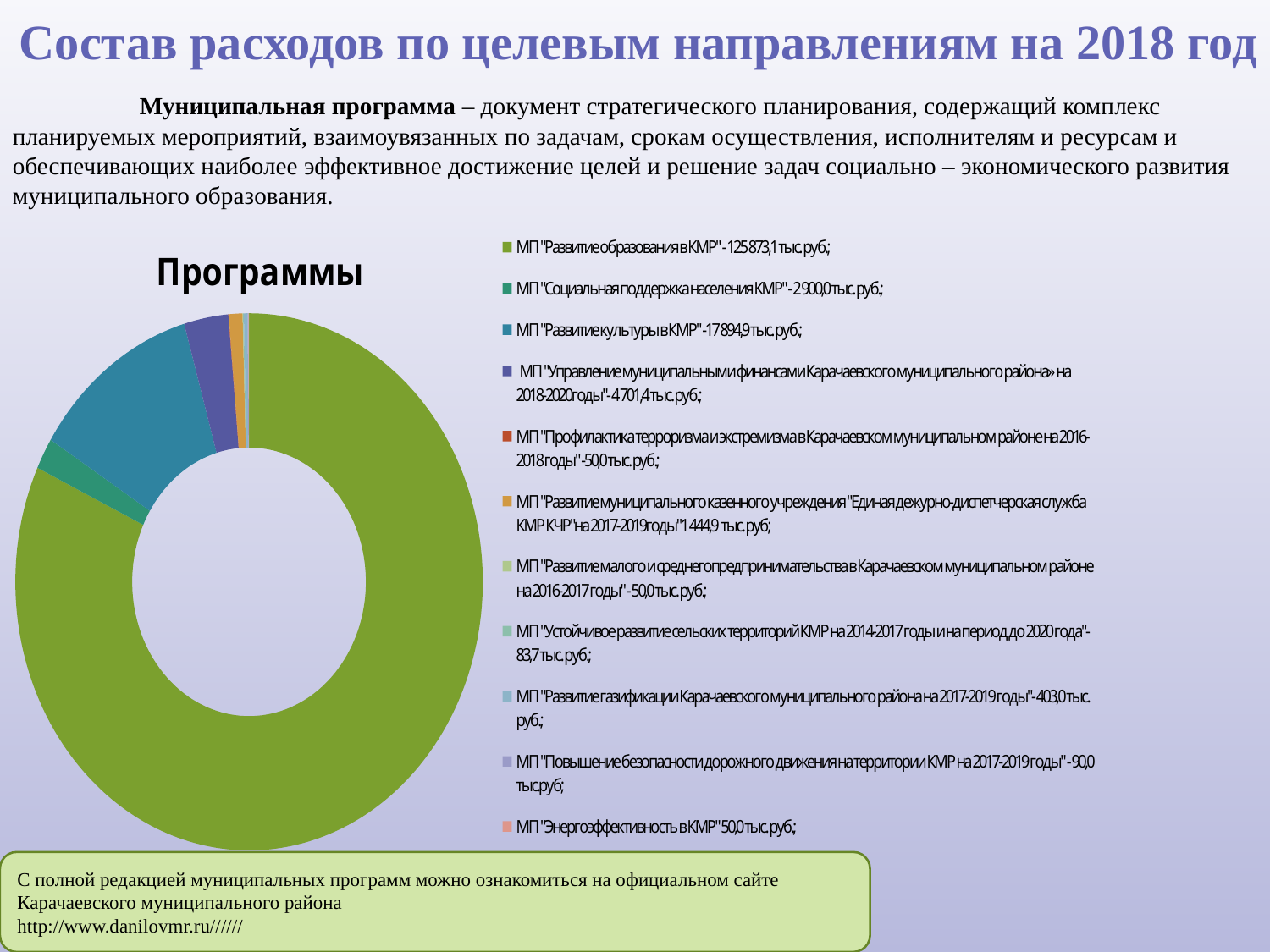
What kind of chart is shown under the heading "Программы"? Pie (doughnut) chart What is the value for МП "Социальная поддержка населения КМР"? 2 900,0 тыс.руб. Which is larger: the value for МП "Развитие культуры в КМР" or МП "Социальная поддержка населения КМР"? МП "Развитие культуры в КМР" What is the title of the chart on the slide? Программы Which programme has the largest share of the chart? МП "Развитие образования в КМР" What is the value for МП "Управление муниципальными финансами Карачаевского муниципального района" на 2018-2020 годы? 4 701,4 тыс.руб. What is the value for МП "Развитие образования в КМР"? 125 873,1 тыс.руб. What is the difference between the values for МП "Развитие образования в КМР" and МП "Развитие культуры в КМР"? 107 978,2 тыс.руб. What is the value for МП "Развитие культуры в КМР"? 17 894,9 тыс.руб. What is the value for МП "Энергоэффективность в КМР"? 50,0 тыс.руб. What is the value for МП "Развитие газификации Карачаевского муниципального района на 2017-2019 годы"? 403,0 тыс.руб. How many programmes (categories) does the chart's legend list? 11